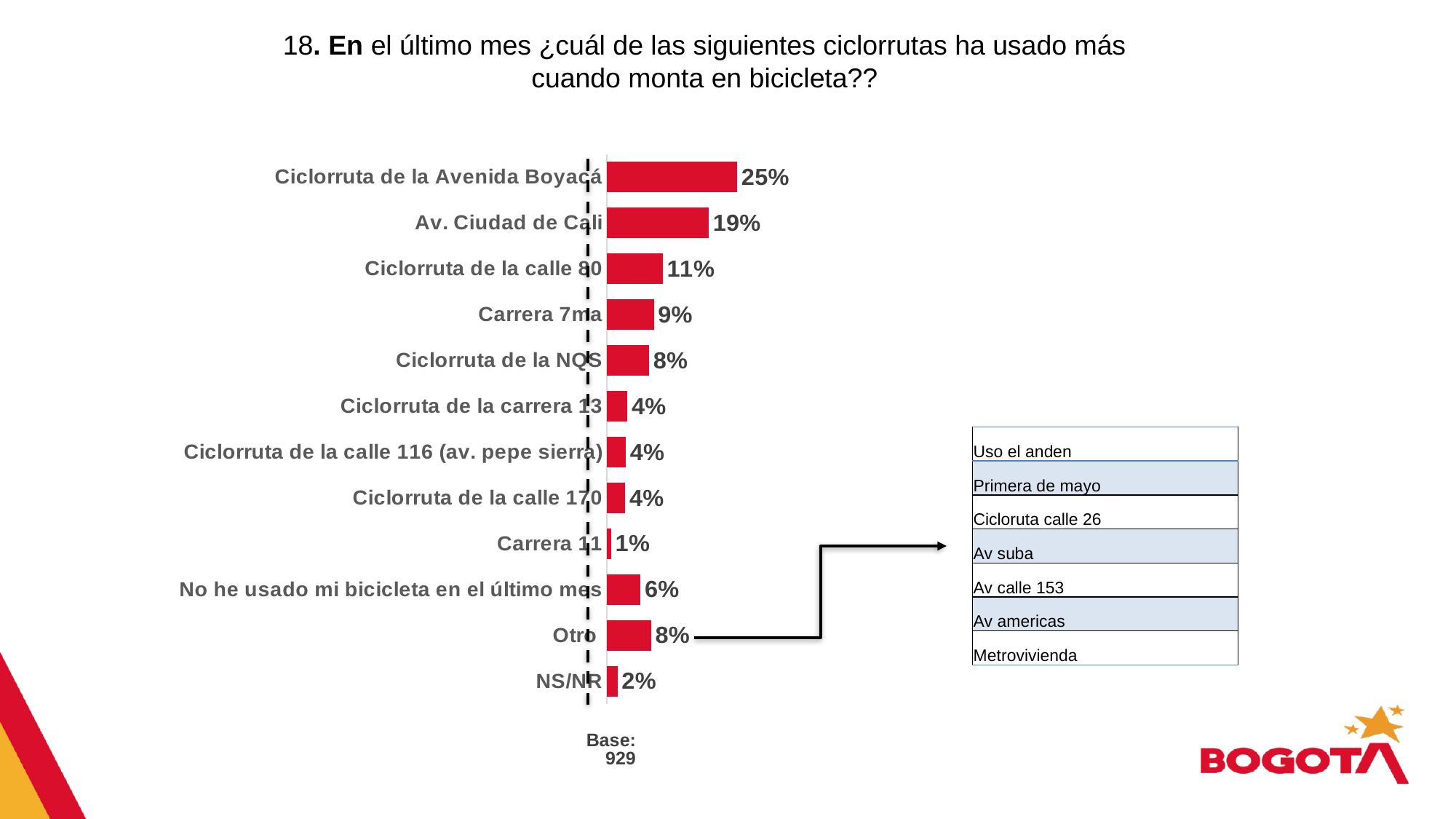
How many categories are shown in the chart? 12 What is the value for Ciclorruta de la calle 80? 11% What is the value for No he usado mi bicicleta en el último mes? 6% Which category has the lowest value? Carrera 11 What is the value for Ciclorruta de la Avenida Boyacá? 25% What is the value for Av. Ciudad de Cali? 19% What is the base (number of respondents) shown below the chart? 929 What kind of chart is shown on the slide? Bar chart Which category has the highest value? Ciclorruta de la Avenida Boyacá Which is larger, the value for Carrera 7ma or the value for Ciclorruta de la NQS? Carrera 7ma What is the value for Otro? 8% What is the difference between the values for Ciclorruta de la Avenida Boyacá and Av. Ciudad de Cali? 6%